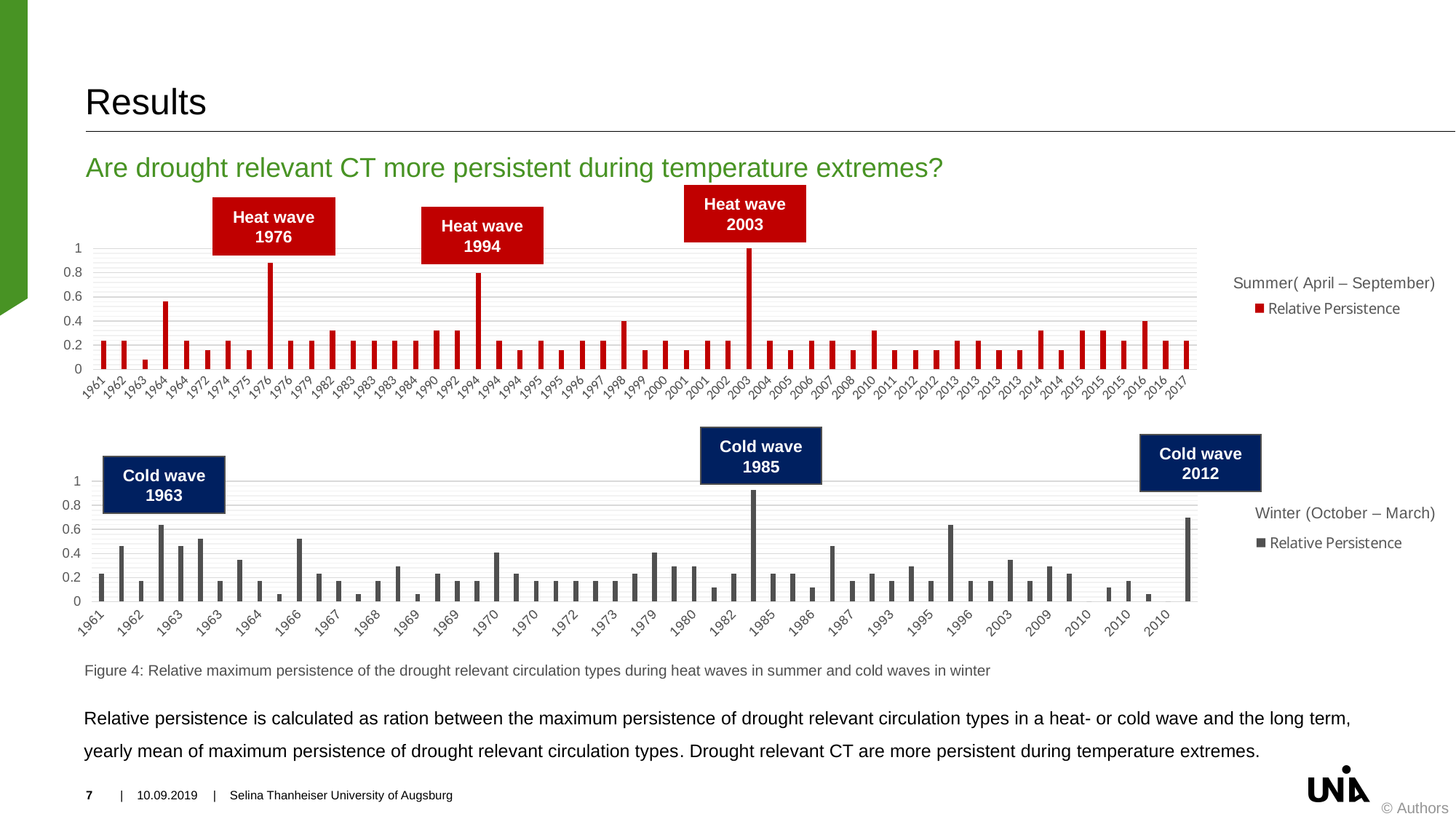
Which three heat wave years are annotated on the Summer (April – September) chart? 1976, 1994, 2003 In the Winter (October – March) chart, which year has the highest relative persistence? 1985 What kind of chart is the Winter (October – March) chart? bar chart In the Summer (April – September) chart, is the value for 2003 greater or less than 0.8? greater In the Summer (April – September) chart, which year has the highest relative persistence? 2003 How many series does the legend of the Summer (April – September) chart list? 1 In the Summer (April – September) chart, which year has the lowest relative persistence? 1963